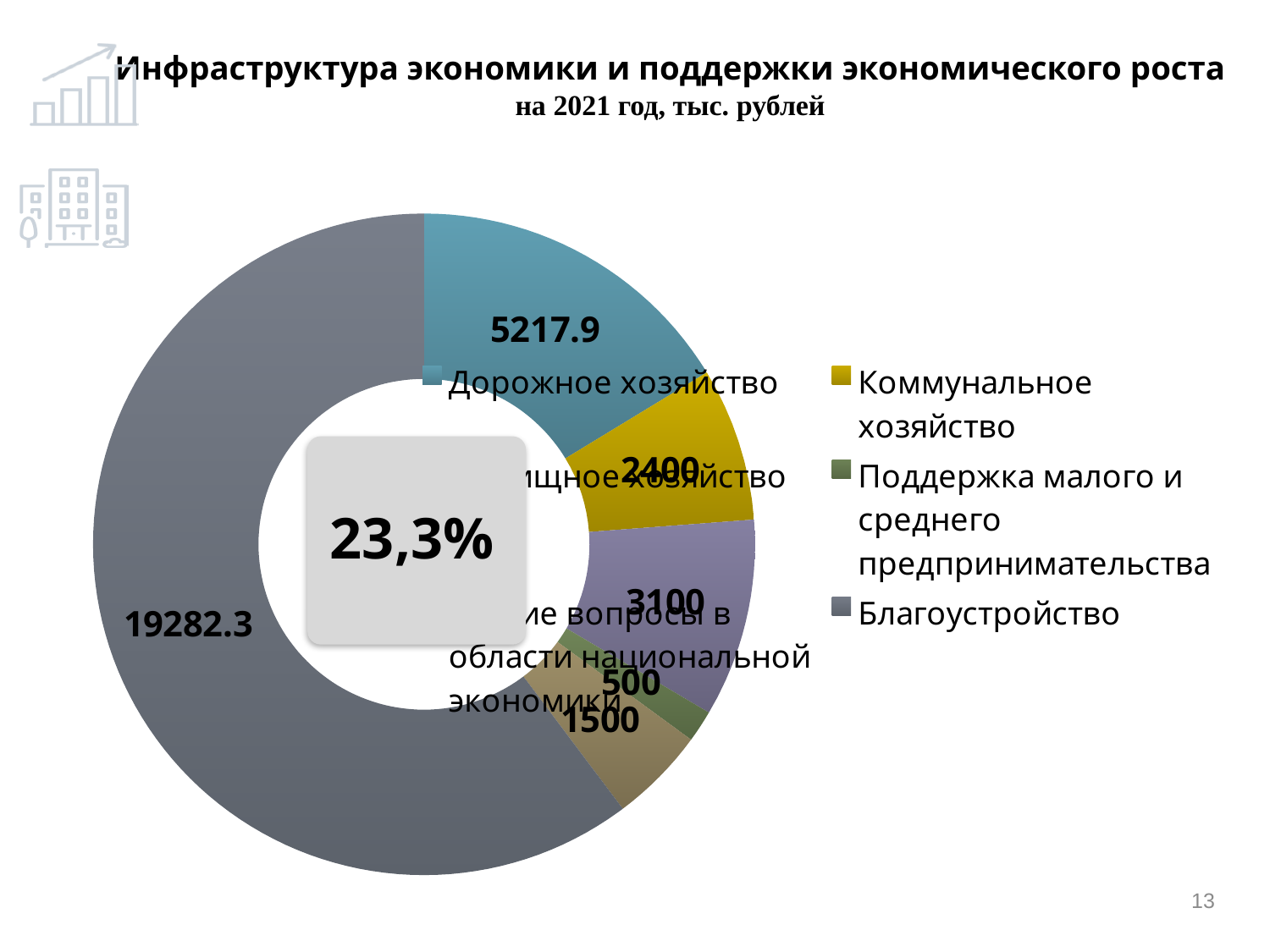
Which category has the smallest slice? Поддержка малого и среднего предпринимательства What is the value for Благоустройство? 19282.3 How many slices does the chart have? 6 Which category has the largest slice? Благоустройство What is the value for Дорожное хозяйство? 5217.9 What is the value for Коммунальное хозяйство? 2400 What kind of chart is shown on the slide? Doughnut (pie) chart What is the value for Поддержка малого и среднего предпринимательства? 500 What percentage is shown in the centre of the doughnut chart? 23,3% What is the difference between the values for Дорожное хозяйство and Коммунальное хозяйство? 2817.9 What is the difference between the values for Благоустройство and Дорожное хозяйство? 14064.4 Which is larger: Коммунальное хозяйство or Поддержка малого и среднего предпринимательства? Коммунальное хозяйство